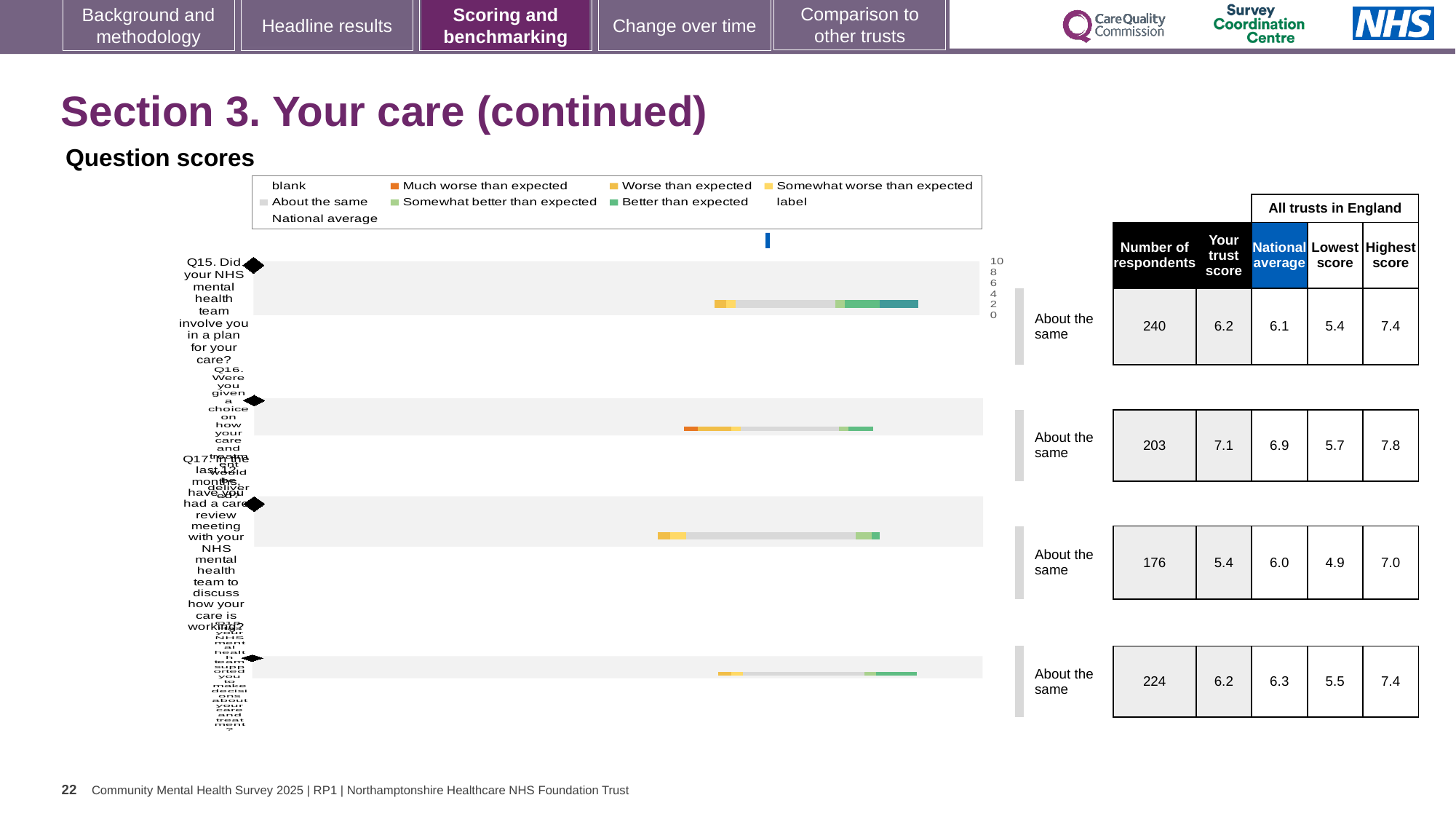
Which question has the highest trust score in the table beside the chart? Q16 How many questions (bars) are plotted in the question scores chart? 4 What kind of chart is used to show the question scores? bar chart What is the lowest score across all trusts in England for Q17? 4.9 In the table beside the chart, how many respondents answered Q16? 203 What colour does the legend use for 'Much worse than expected'? orange Which question has the lowest trust score in the table beside the chart? Q17 What is the highest score across all trusts in England for Q16? 7.8 In the table beside the chart, what is the trust score for Q15 (involving you in a plan for your care)? 6.2 What benchmark category is shown for Q15 next to the chart? About the same For Q17, which is larger: the trust score or the national average? national average What is the difference between the trust score and the national average for Q16? 0.2